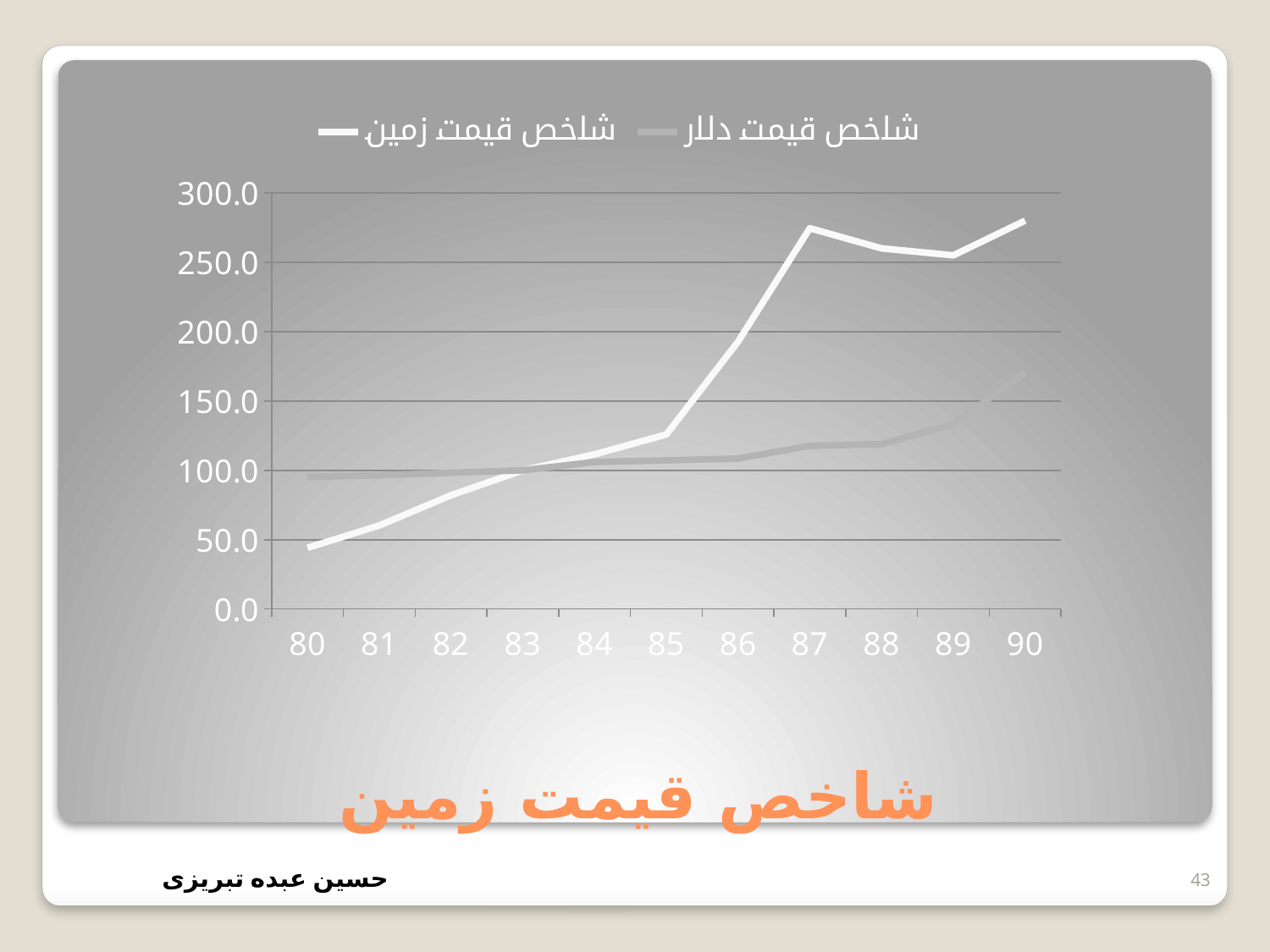
In year 90, which series has the larger value, شاخص قیمت زمین or شاخص قیمت دلار? شاخص قیمت زمین Is the value for شاخص قیمت زمین in year 86 greater or less than 200.0? less How many years are plotted along the x axis? 11 In year 80, which series has the larger value, شاخص قیمت زمین or شاخص قیمت دلار? شاخص قیمت دلار Which year has the highest value for شاخص قیمت دلار? 90 What kind of chart is shown on the slide? line chart How many series does the legend list? 2 Is the value for شاخص قیمت دلار in year 90 greater or less than 150.0? greater Is the value for شاخص قیمت زمین in year 87 greater or less than 250.0? greater Which year has the lowest value for شاخص قیمت زمین? 80 Does the value for شاخص قیمت دلار generally rise or fall from year 80 to year 90? rise